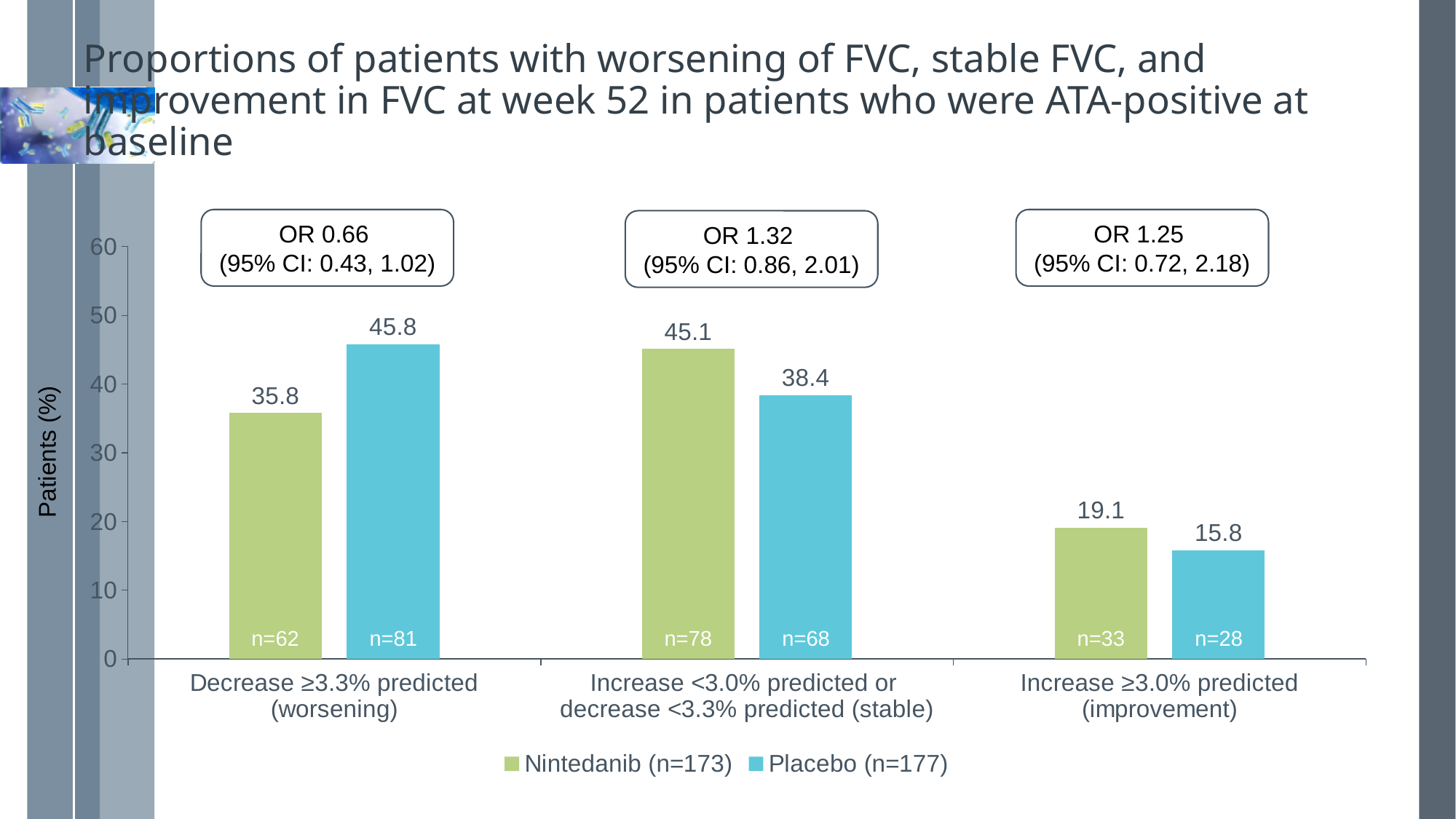
How many series does the legend list? 2 What is the difference between the Placebo and Nintedanib values in the 'Decrease ≥3.3% predicted (worsening)' category? 10.0 What is the value for Placebo in the 'Increase ≥3.0% predicted (improvement)' category? 15.8 How many categories are shown on the x axis? 3 In the 'Increase ≥3.0% predicted (improvement)' category, which is larger, Nintedanib or Placebo? Nintedanib What is the value for Placebo in the 'Increase <3.0% predicted or decrease <3.3% predicted (stable)' category? 38.4 Which category has the lowest Placebo value? Increase ≥3.0% predicted (improvement) What is the value for Nintedanib in the 'Decrease ≥3.3% predicted (worsening)' category? 35.8 Is the Nintedanib value in the stable category greater or less than 40? greater What is the odds ratio shown above the 'Increase ≥3.0% predicted (improvement)' category? OR 1.25 Which category has the highest Nintedanib value? Increase <3.0% predicted or decrease <3.3% predicted (stable) What kind of chart is shown on the slide? Bar chart